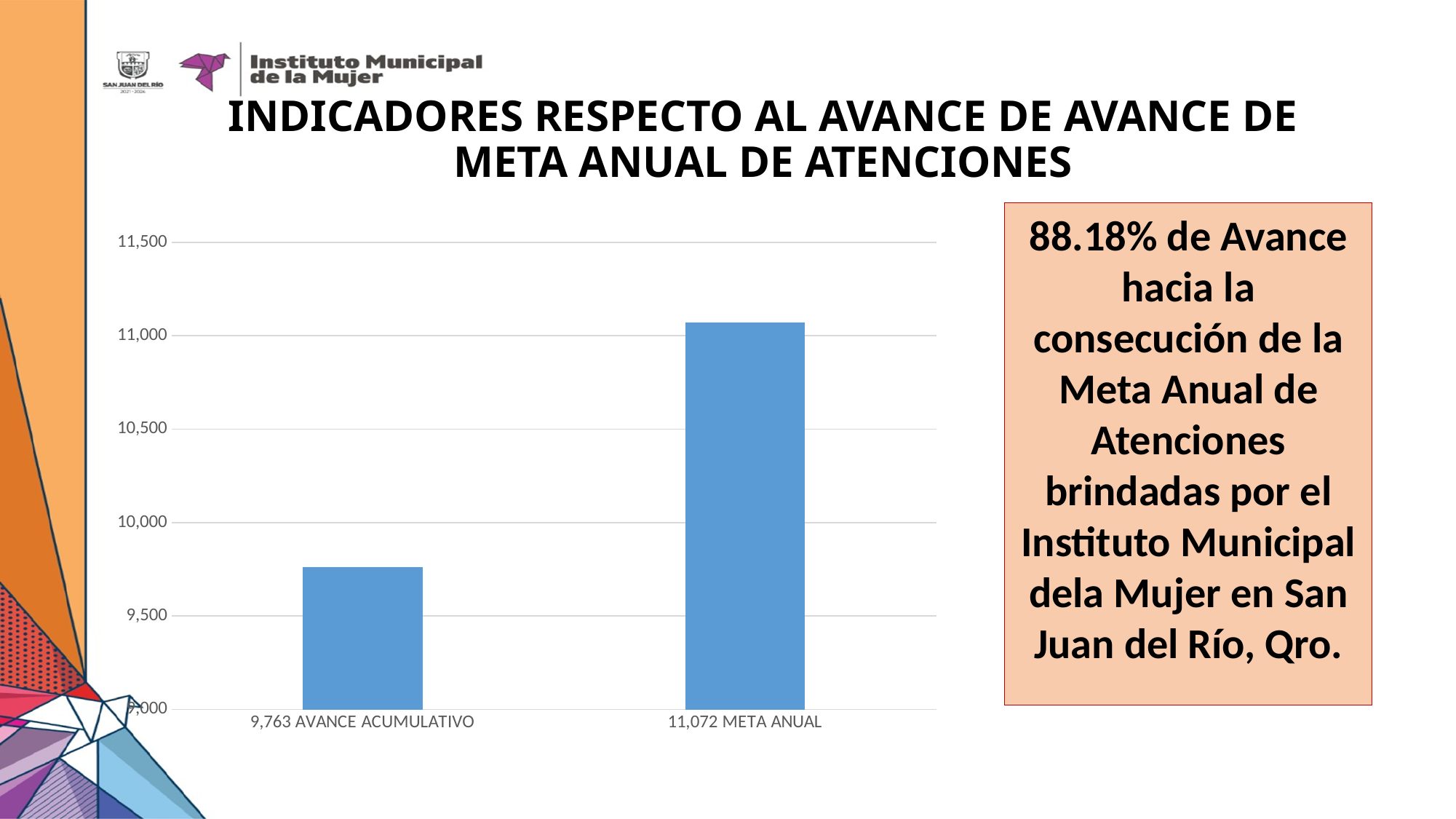
Which category has the lowest value? AVANCE ACUMULATIVO Is the value for AVANCE ACUMULATIVO greater or less than 10,000? less How many bars does the chart show? 2 What is the value for META ANUAL? 11,072 Which category has the highest value? META ANUAL What is the highest value shown on the vertical axis? 11,500 What percentage of progress toward the annual goal is stated in the text box next to the chart? 88.18% What kind of chart is shown on the slide? Bar chart What is the value for AVANCE ACUMULATIVO? 9,763 What is the difference between META ANUAL and AVANCE ACUMULATIVO? 1,309 Which is larger, AVANCE ACUMULATIVO or META ANUAL? META ANUAL Is the value for META ANUAL greater or less than 11,000? greater